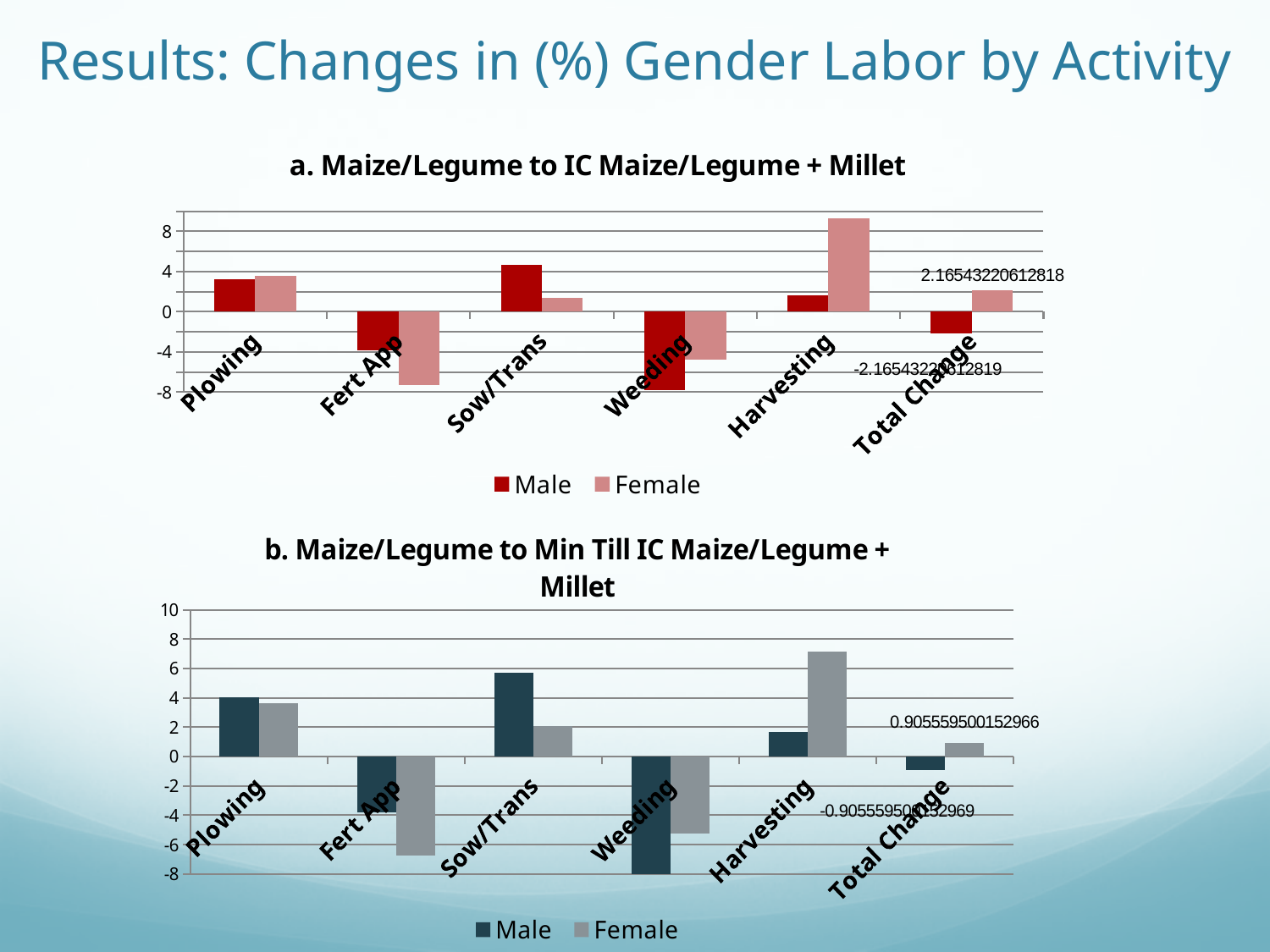
In chart b (Maize/Legume to Min Till IC Maize/Legume + Millet), is the Female value for Harvesting greater or less than 6? greater In chart a (Maize/Legume to IC Maize/Legume + Millet), what is the Female value for Total Change? 2.16543220612818 In chart a (Maize/Legume to IC Maize/Legume + Millet), which activity has the highest Female value? Harvesting In chart b (Maize/Legume to Min Till IC Maize/Legume + Millet), which activity has the lowest Male value? Weeding In chart b (Maize/Legume to Min Till IC Maize/Legume + Millet), which is larger for Sow/Trans, the Male value or the Female value? Male How many series does the legend of chart b (Maize/Legume to Min Till IC Maize/Legume + Millet) list? 2 What are the two series named in the legend of chart b (Maize/Legume to Min Till IC Maize/Legume + Millet)? Male and Female In chart a (Maize/Legume to IC Maize/Legume + Millet), is the Male value for Weeding greater or less than -4? less In chart a (Maize/Legume to IC Maize/Legume + Millet), is the Female value for Fert App greater or less than -4? less What kind of chart is chart a (Maize/Legume to IC Maize/Legume + Millet)? bar chart In chart b (Maize/Legume to Min Till IC Maize/Legume + Millet), what is the Female value for Total Change? 0.905559500152966 How many activity categories are shown on the x axis of chart a (Maize/Legume to IC Maize/Legume + Millet)? 6